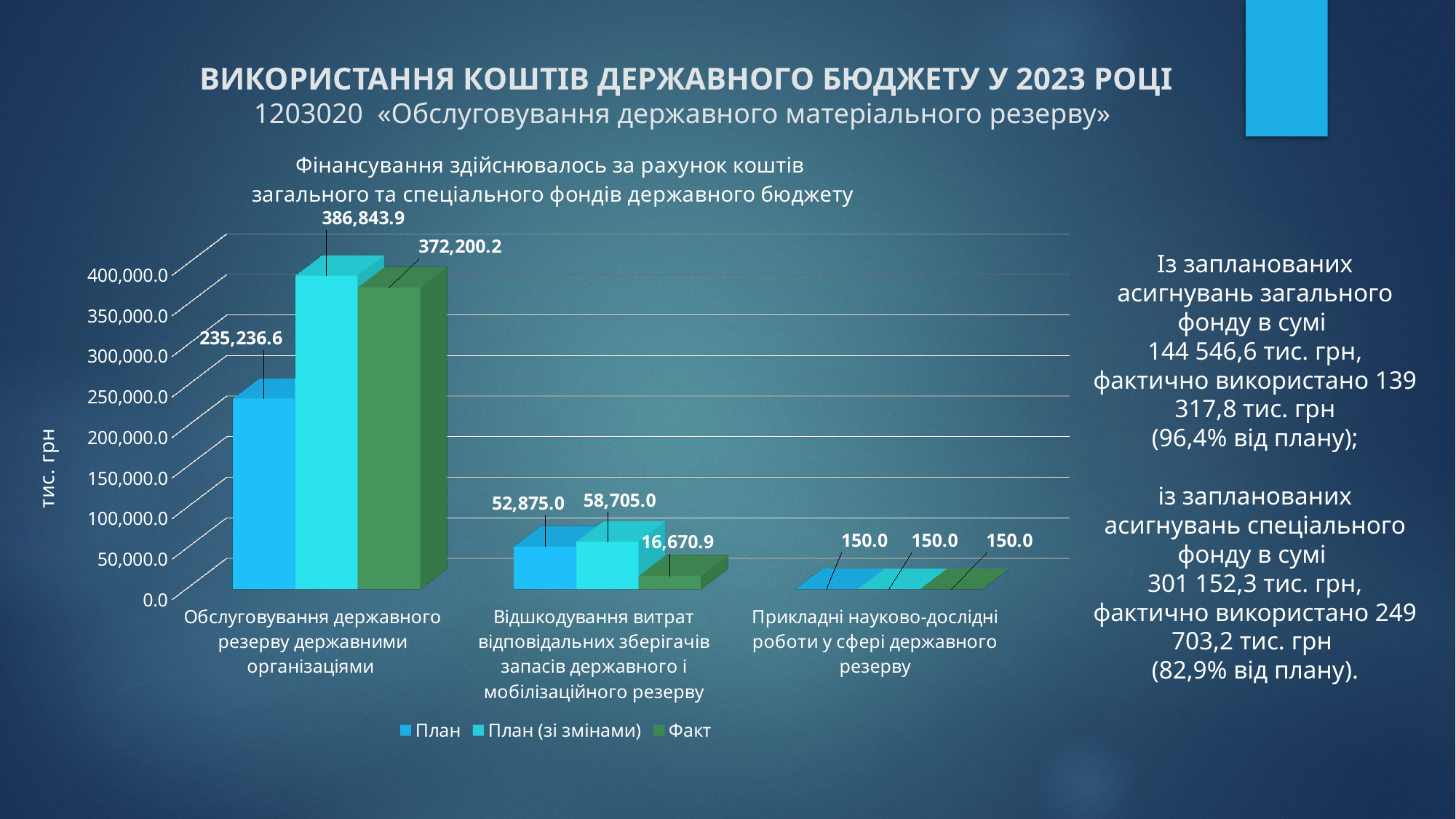
Which category has the highest План (зі змінами) value? Обслуговування державного резерву державними організаціями What is the План value for the category Прикладні науково-дослідні роботи у сфері державного резерву? 150.0 How many series does the chart legend list? 3 What is the difference between the План (зі змінами) and Факт values for the category Обслуговування державного резерву державними організаціями? 14,643.7 For the category Відшкодування витрат відповідальних зберігачів запасів державного і мобілізаційного резерву, which is larger: the План value or the Факт value? План What is the value of the План (зі змінами) series for the category Відшкодування витрат відповідальних зберігачів запасів державного і мобілізаційного резерву? 58,705.0 What is the label of the vertical axis of the chart? тис. грн Which category has the lowest Факт value? Прикладні науково-дослідні роботи у сфері державного резерву What is the value of the Факт series for the category Обслуговування державного резерву державними організаціями? 372,200.2 How many categories are shown on the x axis of the chart? 3 What type of chart is shown on the slide? bar chart Is the План value for Обслуговування державного резерву державними організаціями greater or less than 200,000.0? greater